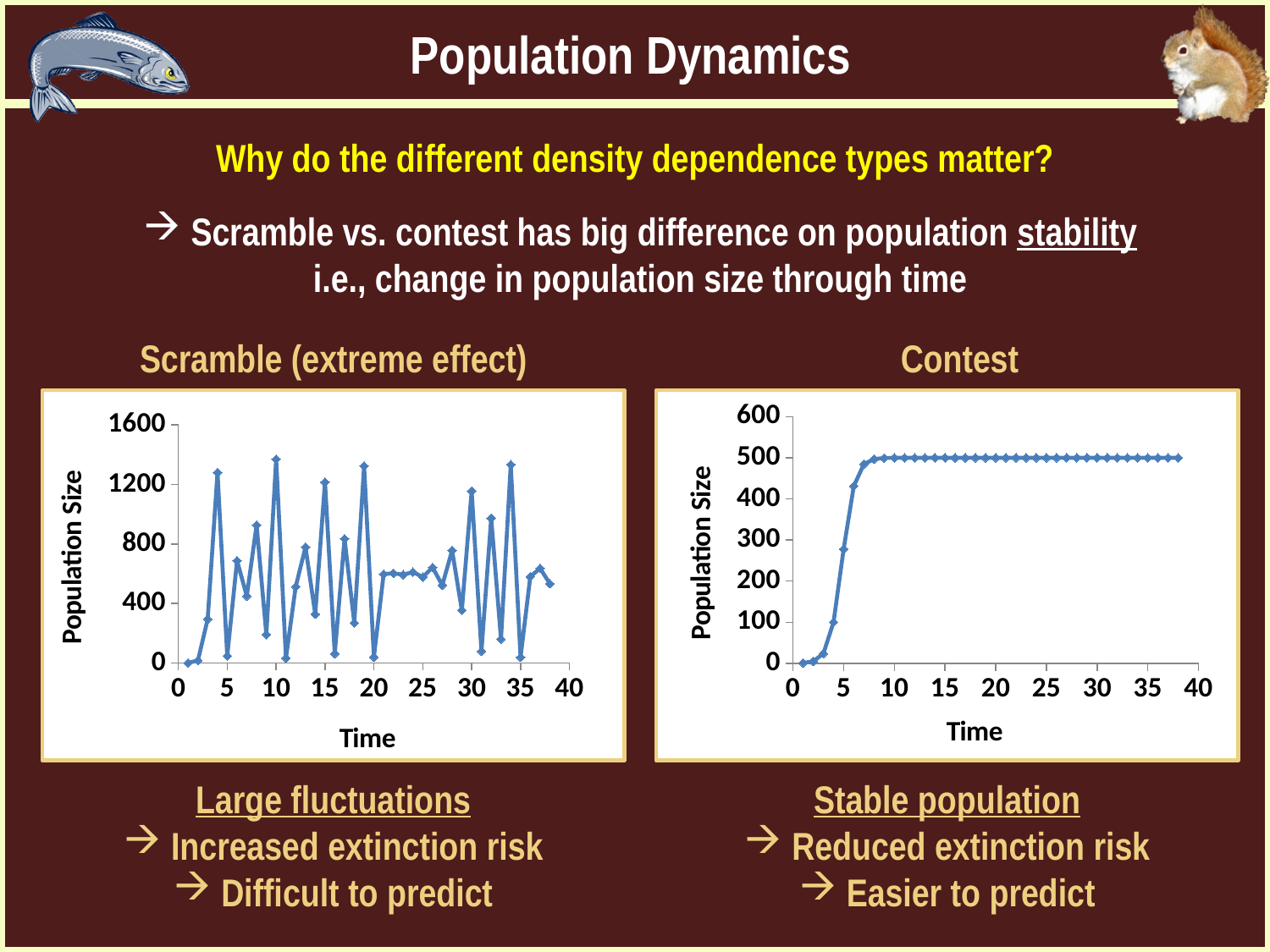
In the Contest chart, at what value does the population size level off? 500 In the Contest chart, is the population size at time 20 greater or less than 400? greater In the Scramble (extreme effect) chart, is the highest population size greater or less than 1200? greater What is the x-axis title of the Contest chart? Time In the Contest chart, do the values rise or fall between time 0 and time 8? rise What kind of chart is the Scramble (extreme effect) chart? line chart In the Scramble (extreme effect) chart, is the population size at time 1 greater or less than 400? less Which chart shows the larger maximum population size, Scramble (extreme effect) or Contest? Scramble (extreme effect) In the Contest chart, do the values rise, fall, or stay flat after about time 10? stay flat What is the highest value shown on the y axis of the Scramble (extreme effect) chart? 1600 What kind of chart is the Contest chart? line chart